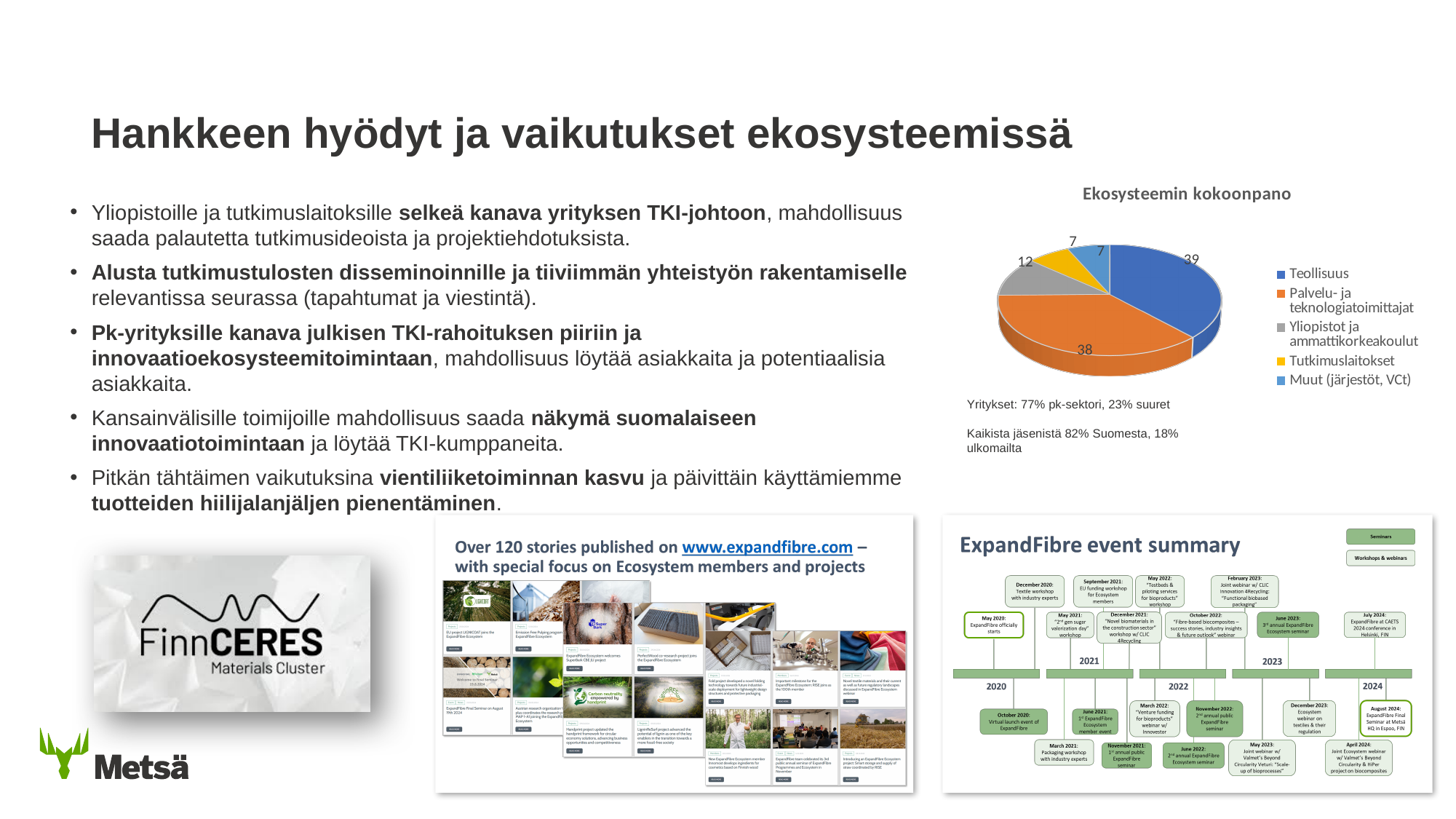
In the 'Ekosysteemin kokoonpano' chart, what is the value for Yliopistot ja ammattikorkeakoulut? 12 What kind of chart is 'Ekosysteemin kokoonpano'? Pie chart In the 'Ekosysteemin kokoonpano' chart, what is the difference between Teollisuus and Palvelu- ja teknologiatoimittajat? 1 In the 'Ekosysteemin kokoonpano' chart, which is larger: Yliopistot ja ammattikorkeakoulut or Muut (järjestöt, VCt)? Yliopistot ja ammattikorkeakoulut What is the title of the pie chart on the slide? Ekosysteemin kokoonpano Which category has the largest slice in the 'Ekosysteemin kokoonpano' chart? Teollisuus In the 'Ekosysteemin kokoonpano' chart, which colour represents Tutkimuslaitokset? Yellow In the 'Ekosysteemin kokoonpano' chart, what is the value for Palvelu- ja teknologiatoimittajat? 38 How many categories does the 'Ekosysteemin kokoonpano' pie chart show? 5 In the 'Ekosysteemin kokoonpano' chart, what is the value for Tutkimuslaitokset? 7 In the 'Ekosysteemin kokoonpano' chart, what is the value for Teollisuus? 39 In the 'Ekosysteemin kokoonpano' chart, what is the difference between Palvelu- ja teknologiatoimittajat and Yliopistot ja ammattikorkeakoulut? 26